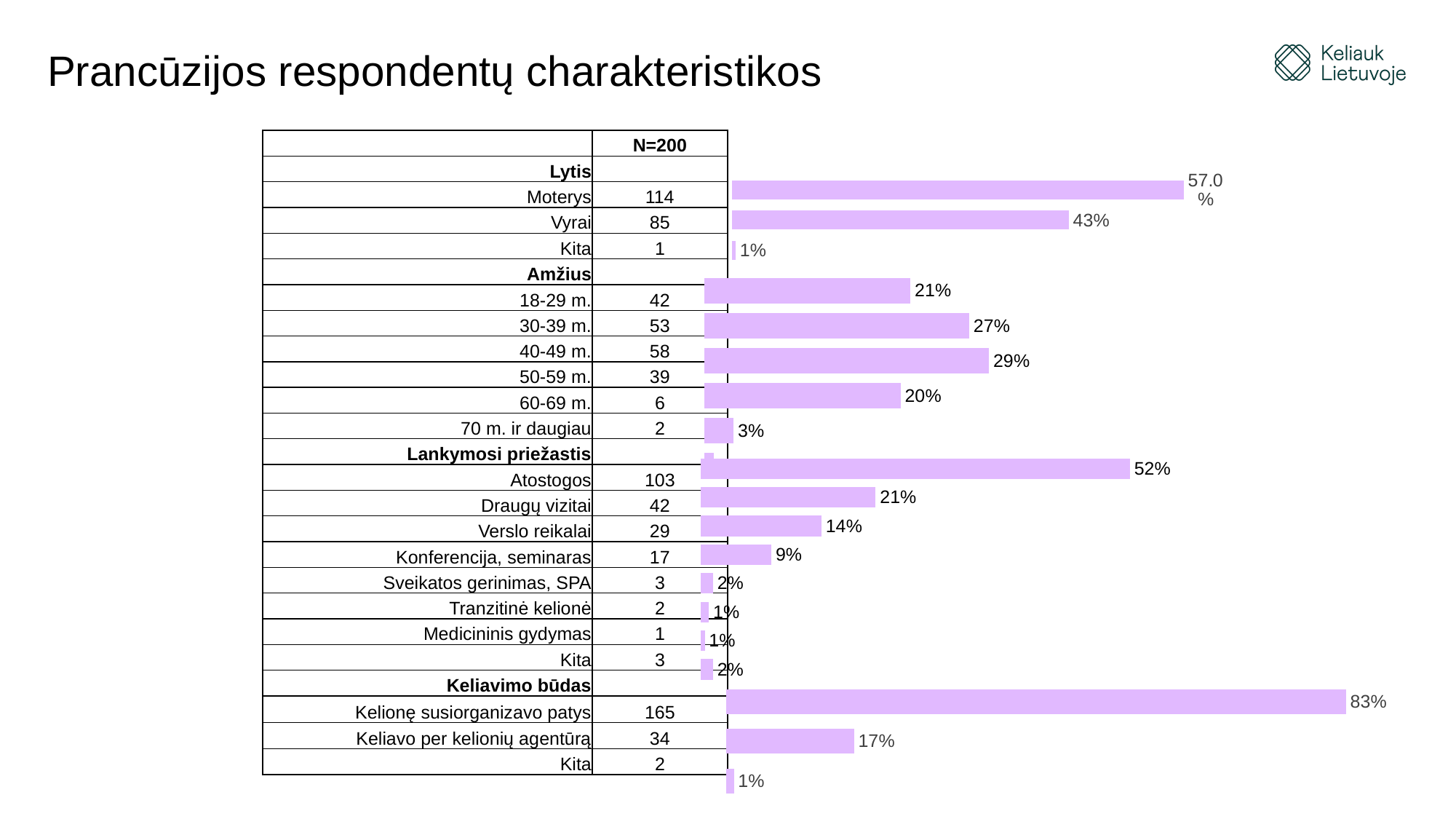
In the Lankymosi priežastis chart, what percentage is shown for Atostogos? 52% In the Lankymosi priežastis chart, what percentage is shown for Konferencija, seminaras? 9% In the Lytis chart, what percentage is shown for Moterys? 57.0% In the Lytis chart, what percentage is shown for Vyrai? 43% In the Keliavimo būdas chart, what percentage is shown for Kelionę susiorganizavo patys? 83% How many categories are plotted in the Lankymosi priežastis chart? 8 In the Keliavimo būdas chart, what is the difference between Kelionę susiorganizavo patys and Keliavo per kelionių agentūrą? 66% In the Amžius chart, what is the difference between the percentages for 40-49 m. and 18-29 m.? 8% In the Amžius chart, what percentage is shown for 30-39 m.? 27% In the Amžius chart, which age group has the highest percentage? 40-49 m. In the Lankymosi priežastis chart, which is larger, Draugų vizitai or Verslo reikalai? Draugų vizitai What type of chart is used on this slide? Bar chart